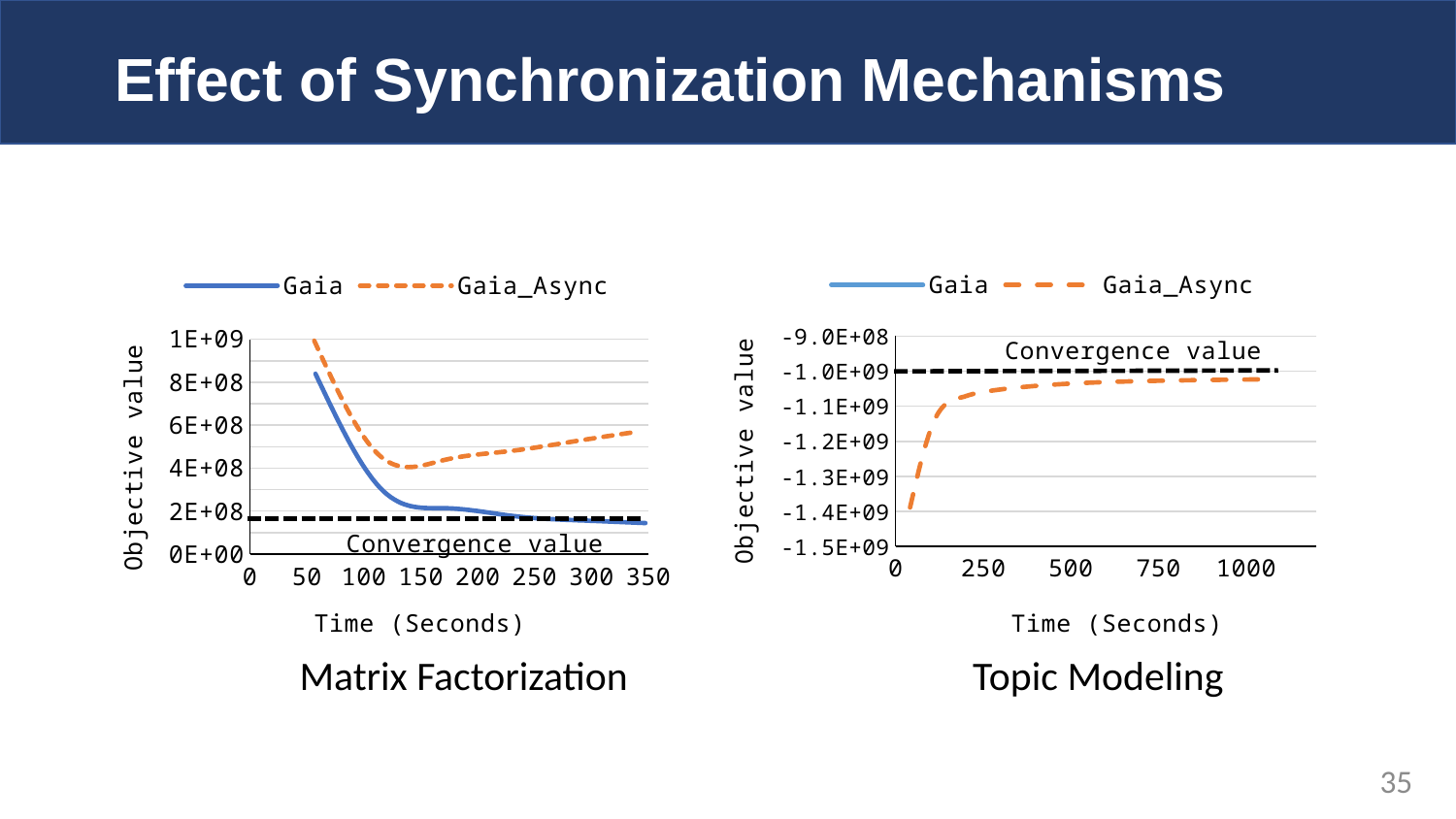
What is the x-axis title of the Topic Modeling chart? Time (Seconds) In the Topic Modeling chart, is the Gaia_Async value at 250 seconds greater or less than -1.2E+09? greater In the Matrix Factorization chart, does the Gaia series rise or fall as time increases? fall How many series does the legend of the Matrix Factorization chart list? 2 How many series does the legend of the Topic Modeling chart list? 2 In the Matrix Factorization chart, is the Gaia_Async value at 350 seconds greater or less than 4E+08? greater In the Matrix Factorization chart, is the Gaia value at 50 seconds greater or less than 6E+08? greater What kind of chart is the Matrix Factorization chart? line chart What kind of chart is the Topic Modeling chart? line chart In the Matrix Factorization chart, which series is drawn with a dashed orange line? Gaia_Async In the Topic Modeling chart, does the Gaia_Async series rise or fall as time increases? rise